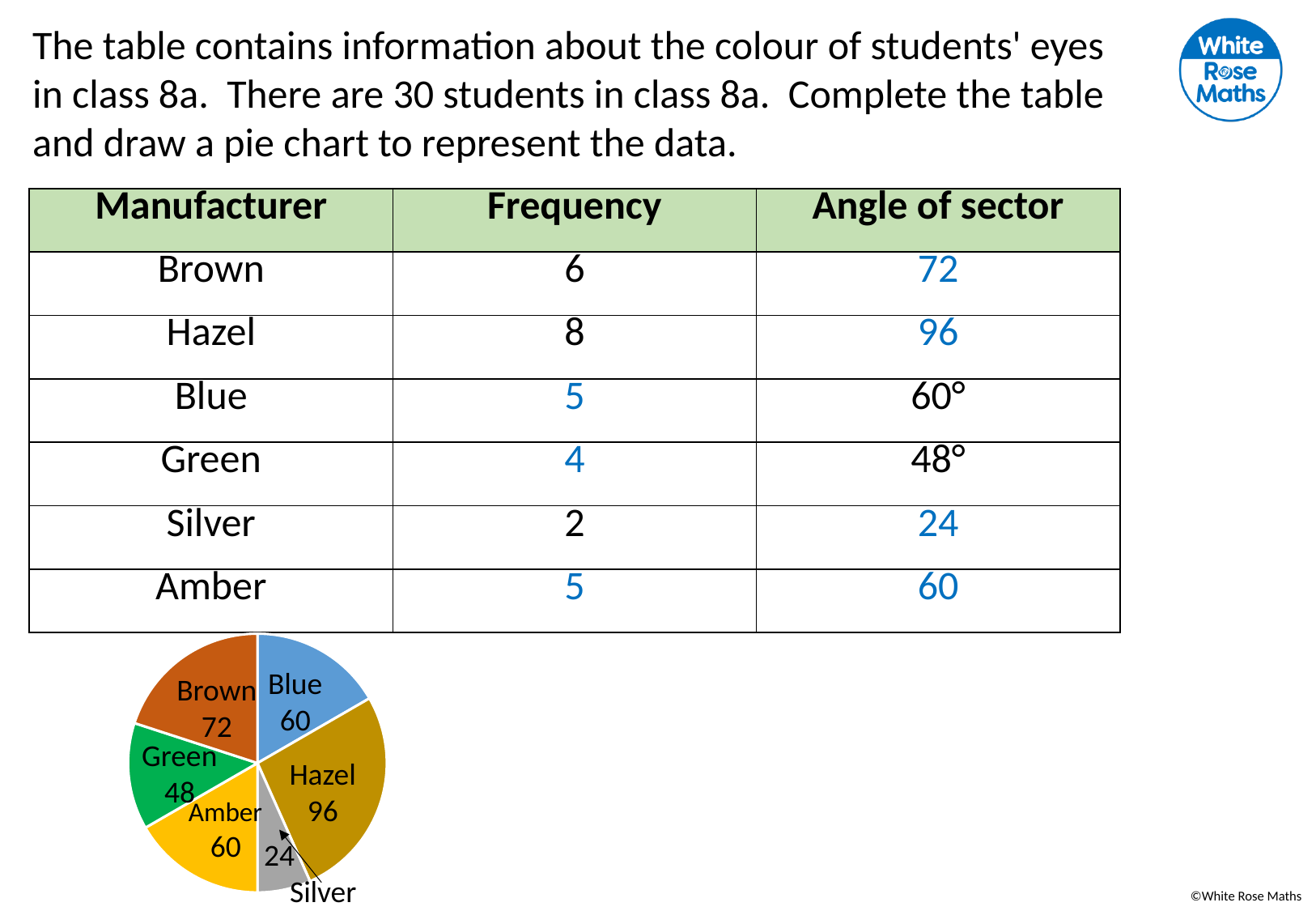
What is the difference between the Hazel and Brown values on the pie chart? 24 Which slice of the pie chart is the largest? Hazel What is the difference between the Amber and Silver values on the pie chart? 36 What value is labelled on the Green slice of the pie chart? 48 What kind of chart is shown on the slide? pie chart What value is labelled on the Silver slice of the pie chart? 24 Which is larger on the pie chart, Brown or Green? Brown What share of the pie chart does the Brown slice represent? 20% How many slices does the pie chart have? 6 What colour is the Hazel slice of the pie chart? gold Which slice of the pie chart is the smallest? Silver What value is labelled on the Hazel slice of the pie chart? 96